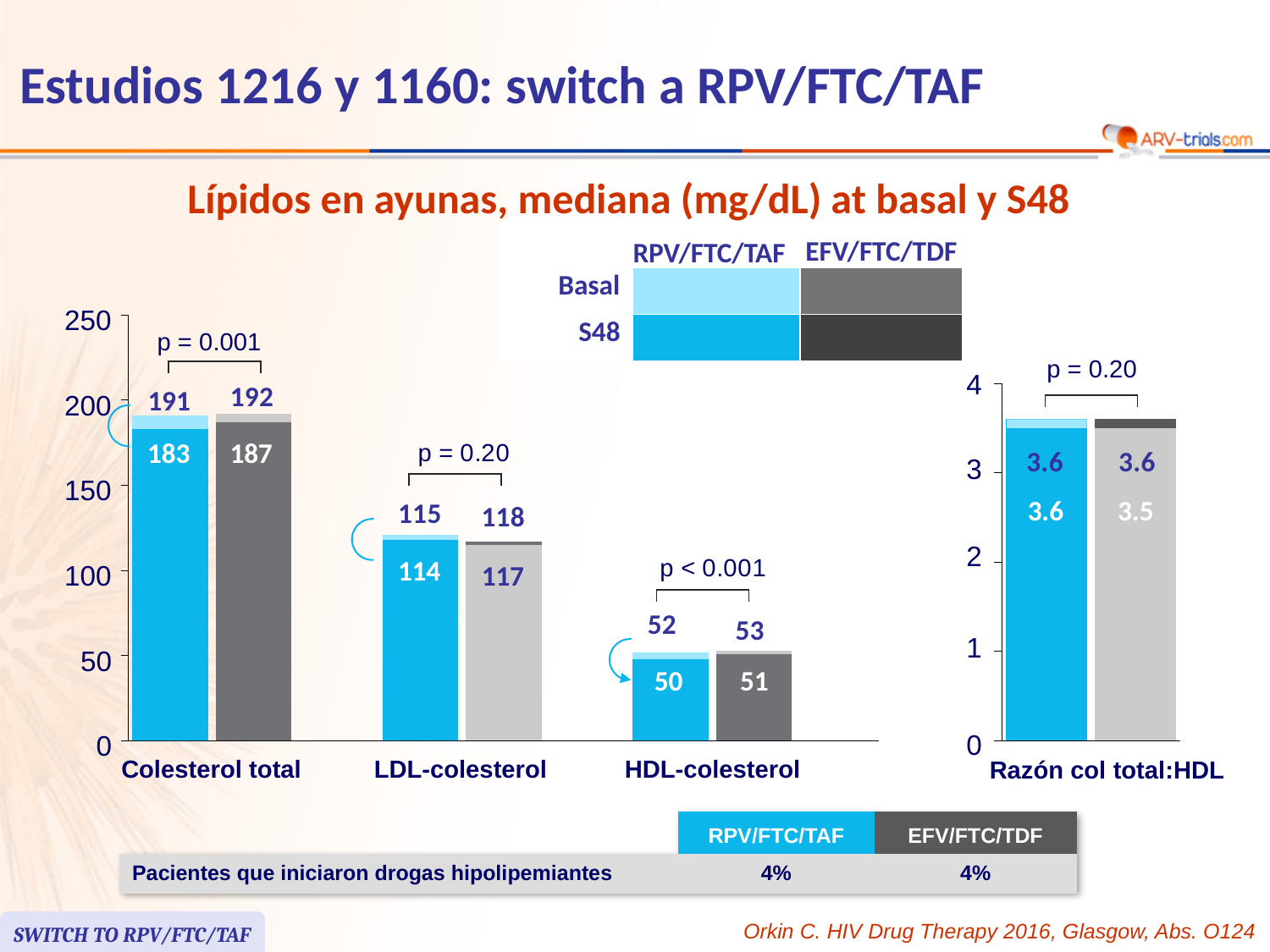
In the left chart, what is the S48 value for RPV/FTC/TAF for Colesterol total? 183 In the left chart, which is larger for LDL-colesterol at S48: RPV/FTC/TAF or EFV/FTC/TDF? EFV/FTC/TDF What p-value is shown for HDL-colesterol in the left chart? p < 0.001 In the left chart, which category has the lowest values? HDL-colesterol In the left chart, what is the difference between the Basal and S48 values for RPV/FTC/TAF for Colesterol total? 8 In the left chart, what is the S48 value for EFV/FTC/TDF for LDL-colesterol? 117 In the right chart, what is the S48 value for EFV/FTC/TDF for Razón col total:HDL? 3.5 How many categories are shown on the x axis of the left chart? 3 What type of chart is used on this slide? Bar chart What is the title of the chart area on the slide? Lípidos en ayunas, mediana (mg/dL) at basal y S48 In the left chart, what is the Basal value for RPV/FTC/TAF for HDL-colesterol? 52 In the left chart, what is the Basal value for EFV/FTC/TDF for Colesterol total? 192